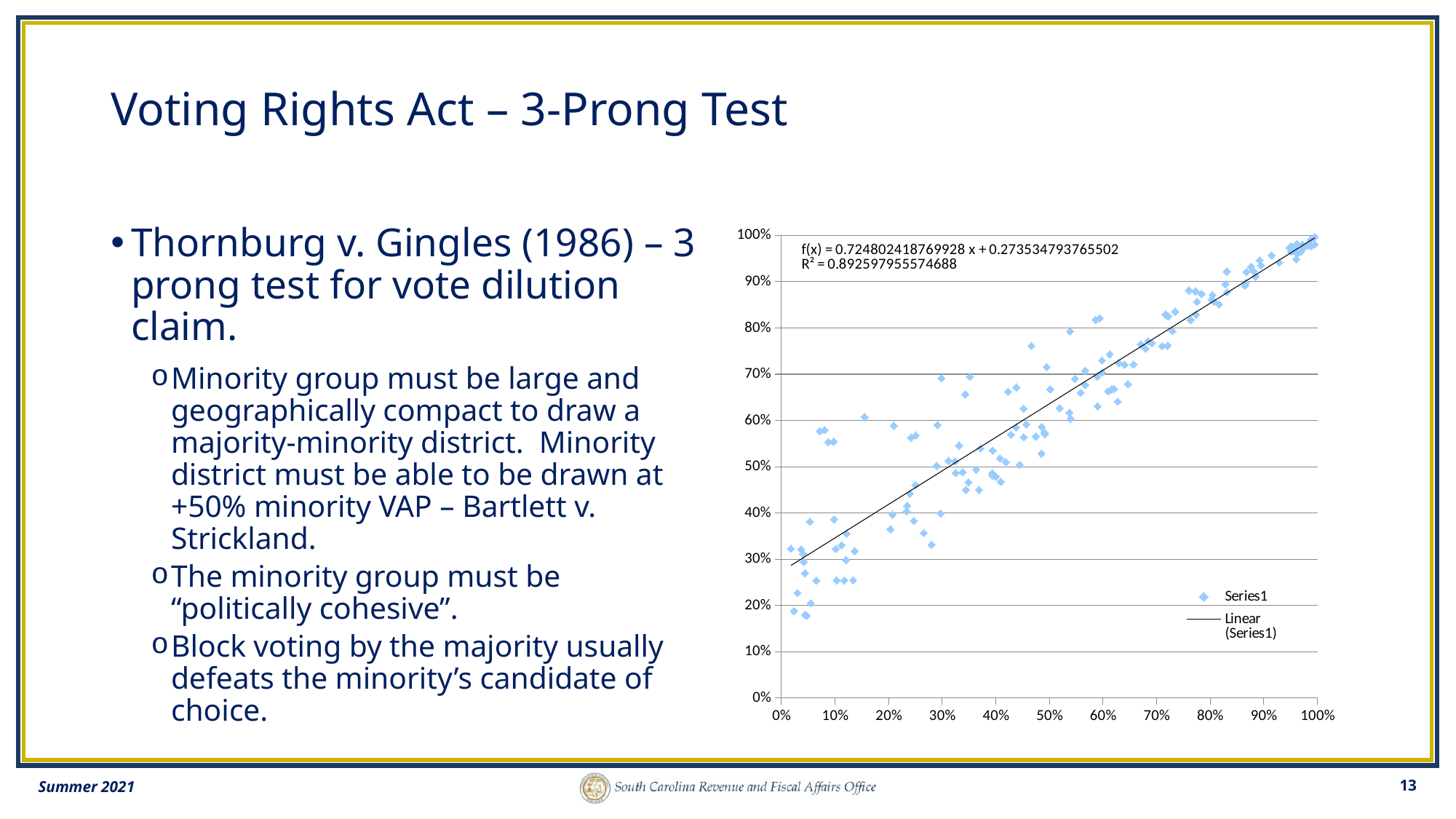
What kind of chart is shown on the slide? Scatter chart Is the y-value of the lowest point on the chart greater or less than 20%? less What is the trendline equation printed on the chart? f(x) = 0.724802418769928 x + 0.273534793765502 What is the slope of the linear trendline shown in the chart's equation? 0.724802418769928 What is the intercept of the linear trendline shown in the chart's equation? 0.273534793765502 How many entries does the chart's legend list? 2 What is the R² value printed on the chart? 0.892597955574688 Is the y-value of the rightmost point on the chart greater or less than 90%? greater Do the plotted points generally rise or fall as the x-axis value increases? Rise